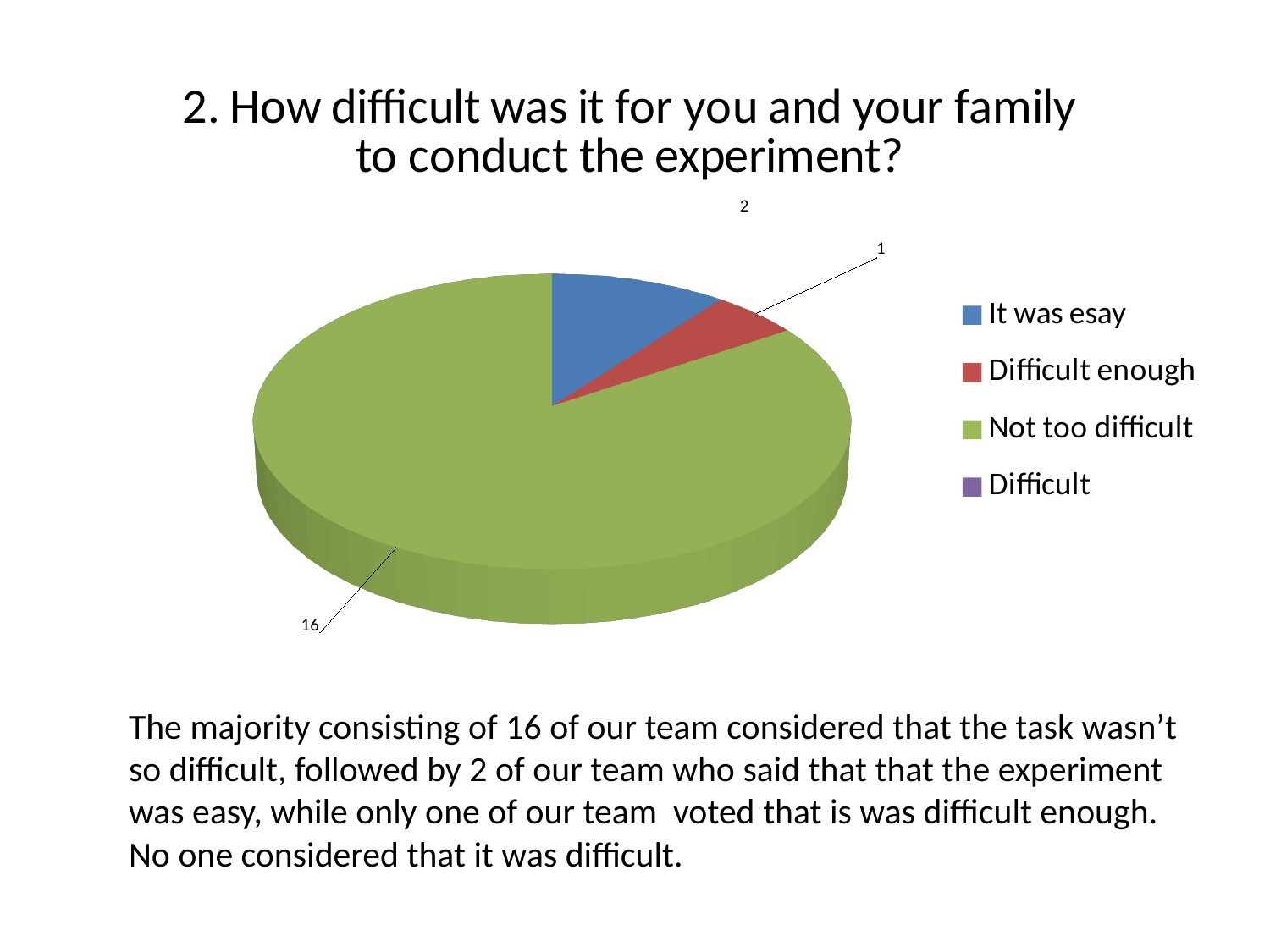
What is the difference between the values for "Not too difficult" and "It was esay"? 14 How many categories does the legend list? 4 What colour represents "Not too difficult" in the pie chart? green What is the value for "Not too difficult"? 16 Which is larger, the value for "It was esay" or the value for "Difficult enough"? It was esay What is the title of the chart? 2. How difficult was it for you and your family to conduct the experiment? What is the difference between the values for "Not too difficult" and "Difficult enough"? 15 What type of chart is shown on the slide? pie chart What is the difference between the values for "It was esay" and "Difficult enough"? 1 What is the value for "It was esay"? 2 Which category has the largest slice of the pie? Not too difficult What is the value for "Difficult enough"? 1